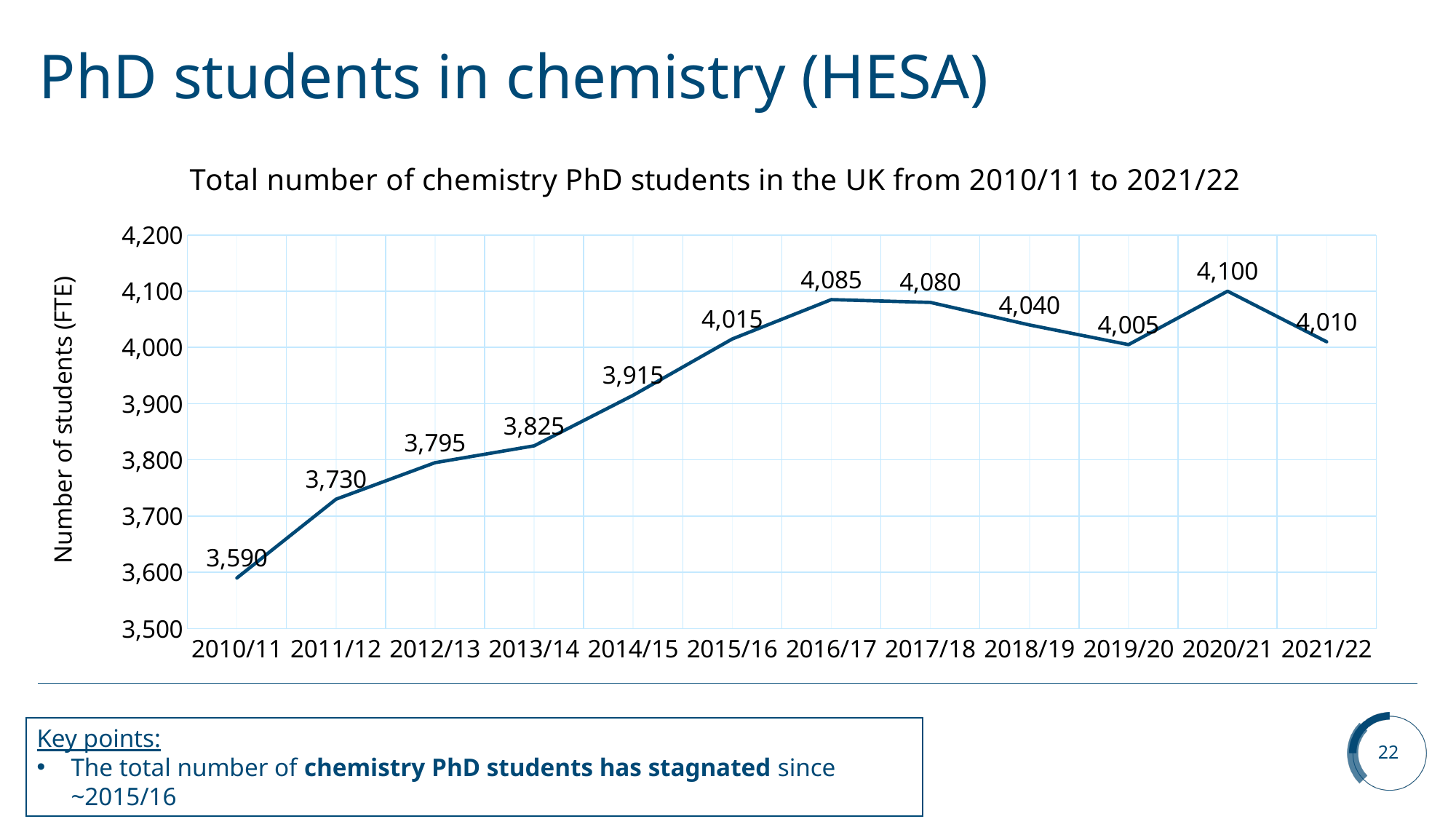
What is the label of the vertical axis of the chart? Number of students (FTE) How many academic years are plotted on the chart? 12 What is the number of chemistry PhD students in 2016/17? 4,085 What is the difference in the number of chemistry PhD students between 2020/21 and 2010/11? 510 What kind of chart is shown on the slide? line chart What is the number of chemistry PhD students in 2021/22? 4,010 Which academic year has the highest number of chemistry PhD students? 2020/21 Does the number of chemistry PhD students rise or fall from 2010/11 to 2016/17? rise Is the number of chemistry PhD students in 2014/15 greater or less than 4,000? less Which academic year has the lowest number of chemistry PhD students? 2010/11 Which year has more chemistry PhD students, 2013/14 or 2015/16? 2015/16 What is the number of chemistry PhD students in 2010/11? 3,590